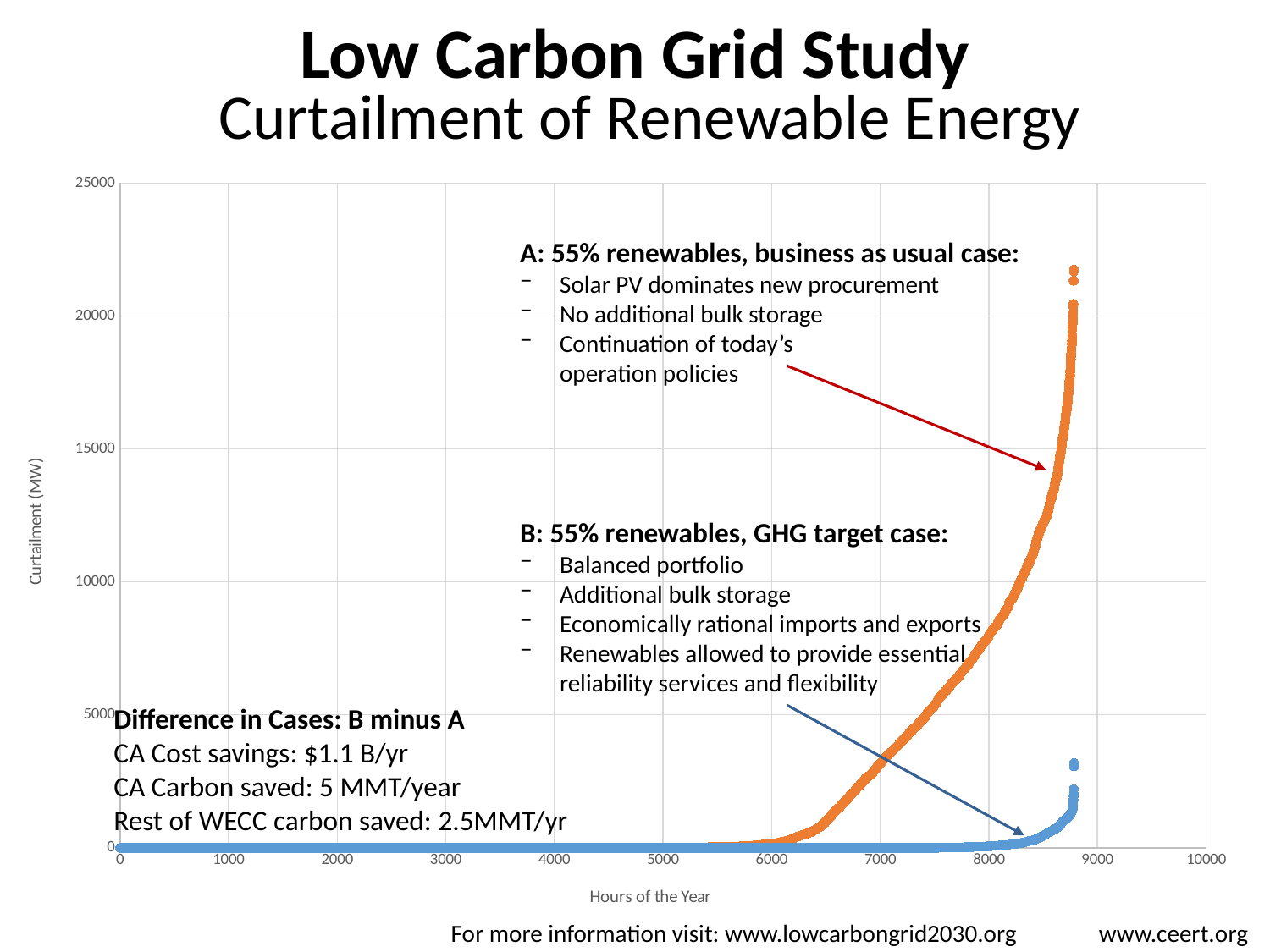
How many data series are plotted on the chart? 2 Do the curtailment values rise or fall as hours of the year increase along the x axis? rise At 8500 hours of the year, which series has the higher curtailment, case A (orange) or case B (blue)? case A (orange) Is the highest value of the blue series (case B, GHG target case) greater or less than 5000? less What is the title of the y axis of the chart? Curtailment (MW) What is the title of the x axis of the chart? Hours of the Year Which series reaches the highest curtailment value on the chart, case A (business as usual) or case B (GHG target case)? case A (business as usual) What kind of chart is shown on the slide? scatter chart At 8000 hours of the year, is the value of the orange series (case A) greater or less than 5000? greater At 8000 hours of the year, is the value of the blue series (case B) greater or less than 5000? less